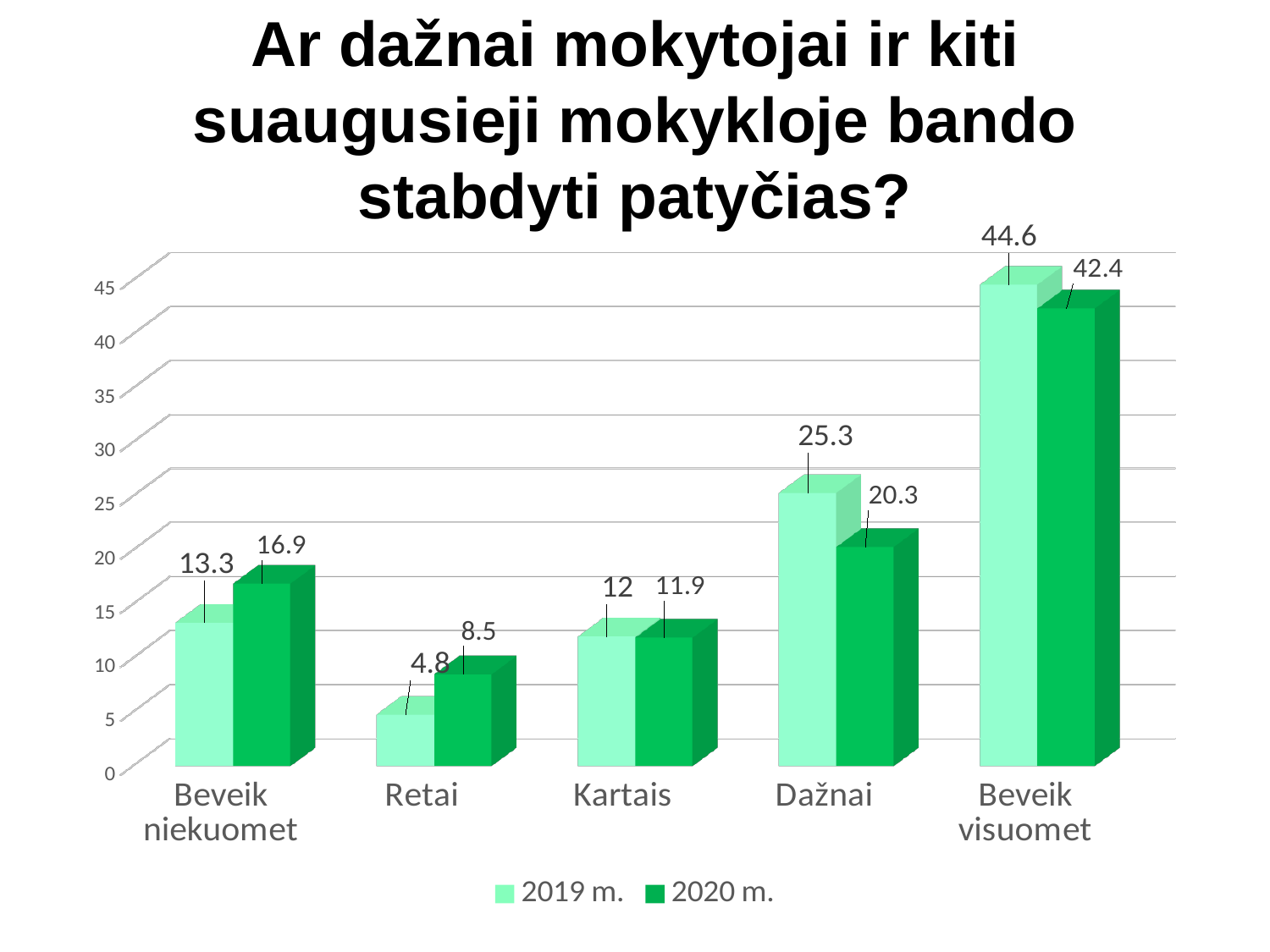
What is the difference between the 2019 m. values for 'Beveik visuomet' and 'Beveik niekuomet'? 31.3 What kind of chart is shown on the slide? Bar chart What is the difference between the 2019 m. and 2020 m. values for 'Dažnai'? 5 What are the two series named in the legend? 2019 m. and 2020 m. How many categories are shown on the x axis? 5 Which category has the lowest value in the 2020 m. series? Retai Which category has the highest value in the 2019 m. series? Beveik visuomet What is the value for 'Dažnai' in the 2020 m. series? 20.3 What is the value for 'Retai' in the 2020 m. series? 8.5 What is the value for 'Beveik visuomet' in the 2019 m. series? 44.6 How many series does the legend list? 2 Which is larger for 'Beveik niekuomet': the 2019 m. value or the 2020 m. value? 2020 m.